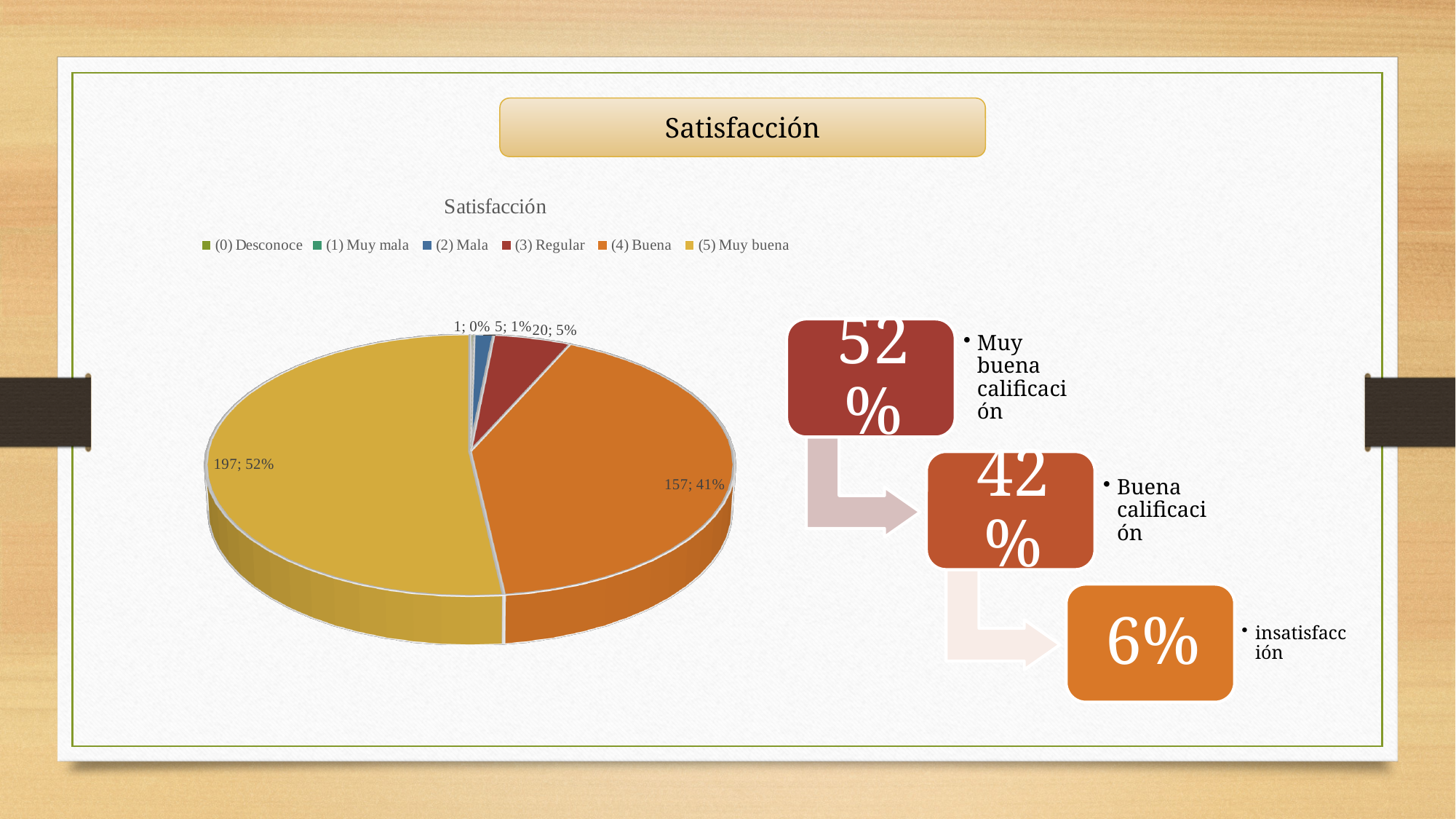
What count is shown for the (4) Buena slice? 157 What percentage share does the (4) Buena slice have? 41% What percentage share does the (3) Regular slice have? 5% What count is shown for the (3) Regular slice? 20 What count is shown for the (5) Muy buena slice? 197 How many categories does the chart legend list? 6 What percentage share does the (5) Muy buena slice have? 52% What is the title of the chart? Satisfacción What is the difference in count between the (5) Muy buena slice and the (4) Buena slice? 40 Which category has the largest slice of the pie? (5) Muy buena Which is larger, the (4) Buena slice or the (3) Regular slice? (4) Buena What kind of chart is shown on the slide? Pie chart